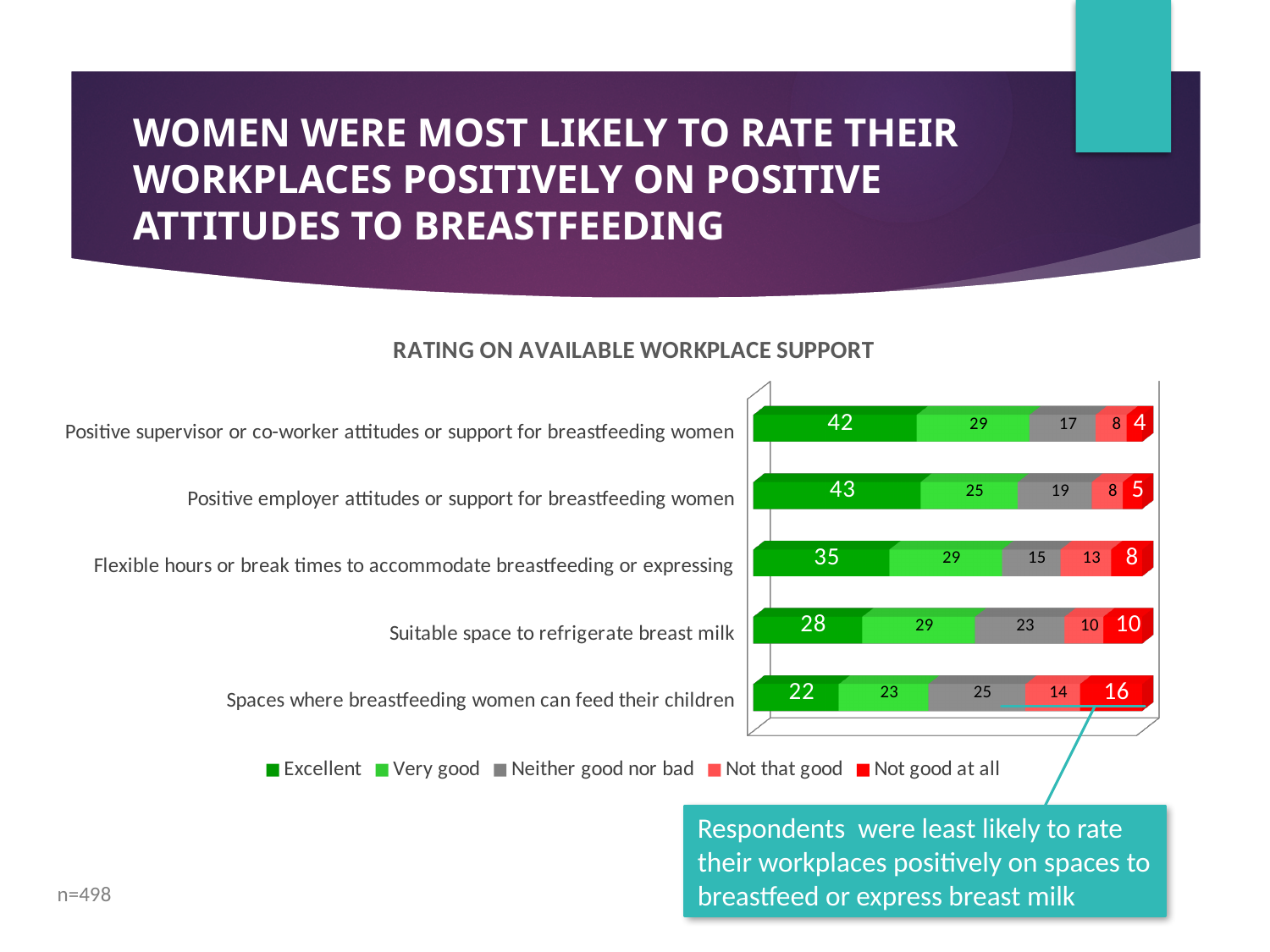
How many series does the legend list? 5 What is the Excellent value for 'Positive employer attitudes or support for breastfeeding women'? 43 What is the title of the chart? RATING ON AVAILABLE WORKPLACE SUPPORT What is the total of the stacked bar for 'Positive supervisor or co-worker attitudes or support for breastfeeding women'? 100 Which category has the lowest Excellent value? Spaces where breastfeeding women can feed their children What is the Not good at all value for 'Spaces where breastfeeding women can feed their children'? 16 What kind of chart is shown on the slide? Stacked bar chart How many categories are plotted on the chart? 5 What is the difference between the Excellent values for 'Flexible hours or break times to accommodate breastfeeding or expressing' and 'Suitable space to refrigerate breast milk'? 7 Which category has the highest Excellent value? Positive employer attitudes or support for breastfeeding women Which is larger: the Not that good value for 'Flexible hours or break times to accommodate breastfeeding or expressing' or for 'Positive employer attitudes or support for breastfeeding women'? Flexible hours or break times to accommodate breastfeeding or expressing What is the Neither good nor bad value for 'Suitable space to refrigerate breast milk'? 23